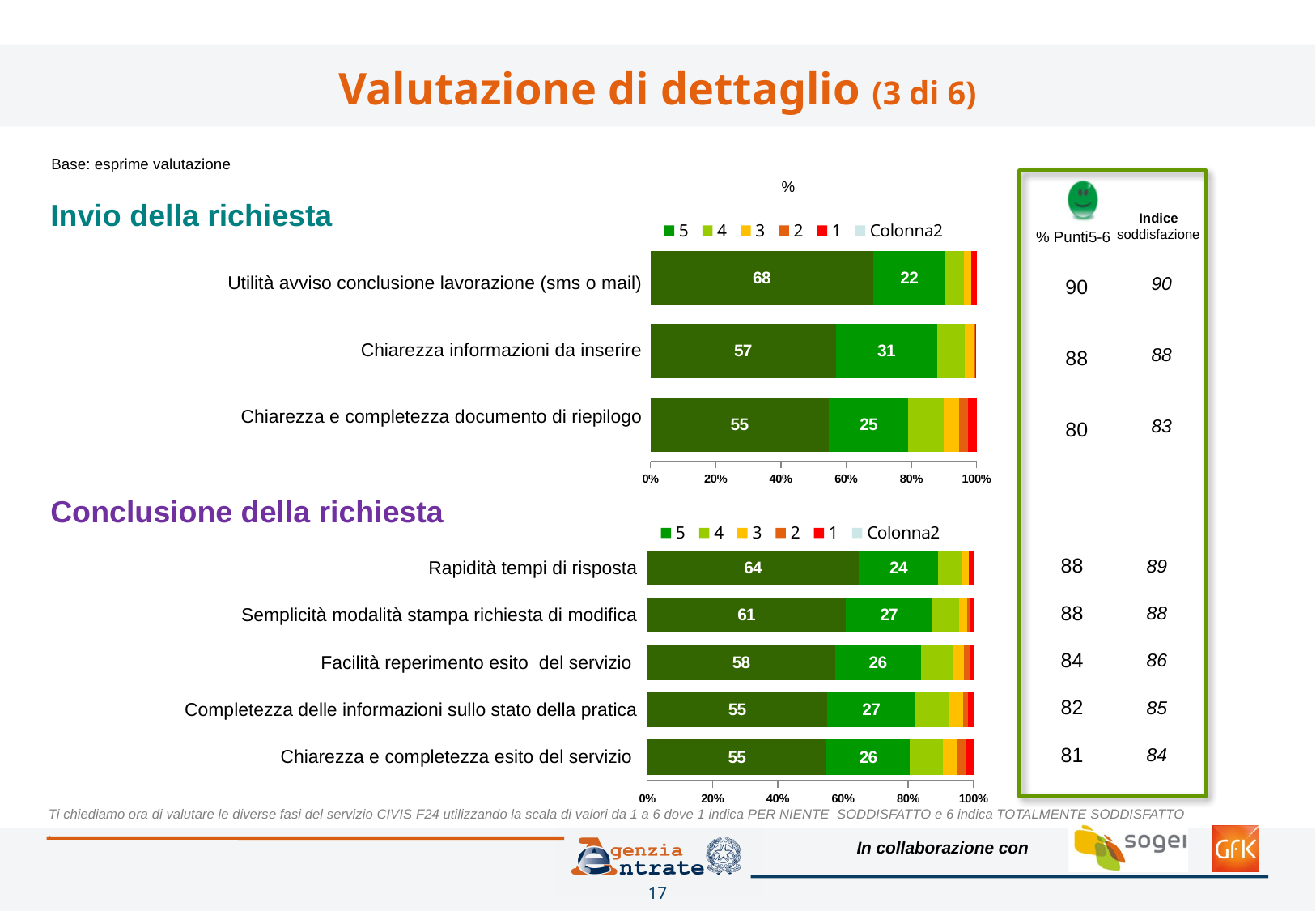
In the 'Invio della richiesta' chart, which category has the highest value for series 5? Chiarezza informazioni da inserire In the 'Invio della richiesta' chart, what is the value of series 5 for 'Utilità avviso conclusione lavorazione (sms o mail)'? 22 What type of chart is the 'Invio della richiesta' chart? Stacked bar chart In the 'Invio della richiesta' chart, what is the difference between the series 5 values for 'Utilità avviso conclusione lavorazione (sms o mail)' and 'Chiarezza e completezza documento di riepilogo'? 3 In the 'Conclusione della richiesta' chart, is the series 5 value larger for 'Semplicità modalità stampa richiesta di modifica' or for 'Facilità reperimento esito del servizio'? Semplicità modalità stampa richiesta di modifica How many series does the legend of the 'Conclusione della richiesta' chart list? 6 In the 'Conclusione della richiesta' chart, which category has the lowest value for series 4? Rapidità tempi di risposta How many categories are plotted in the 'Invio della richiesta' chart? 3 In the 'Conclusione della richiesta' chart, what is the value of series 5 for 'Rapidità tempi di risposta'? 24 How many categories are plotted in the 'Conclusione della richiesta' chart? 5